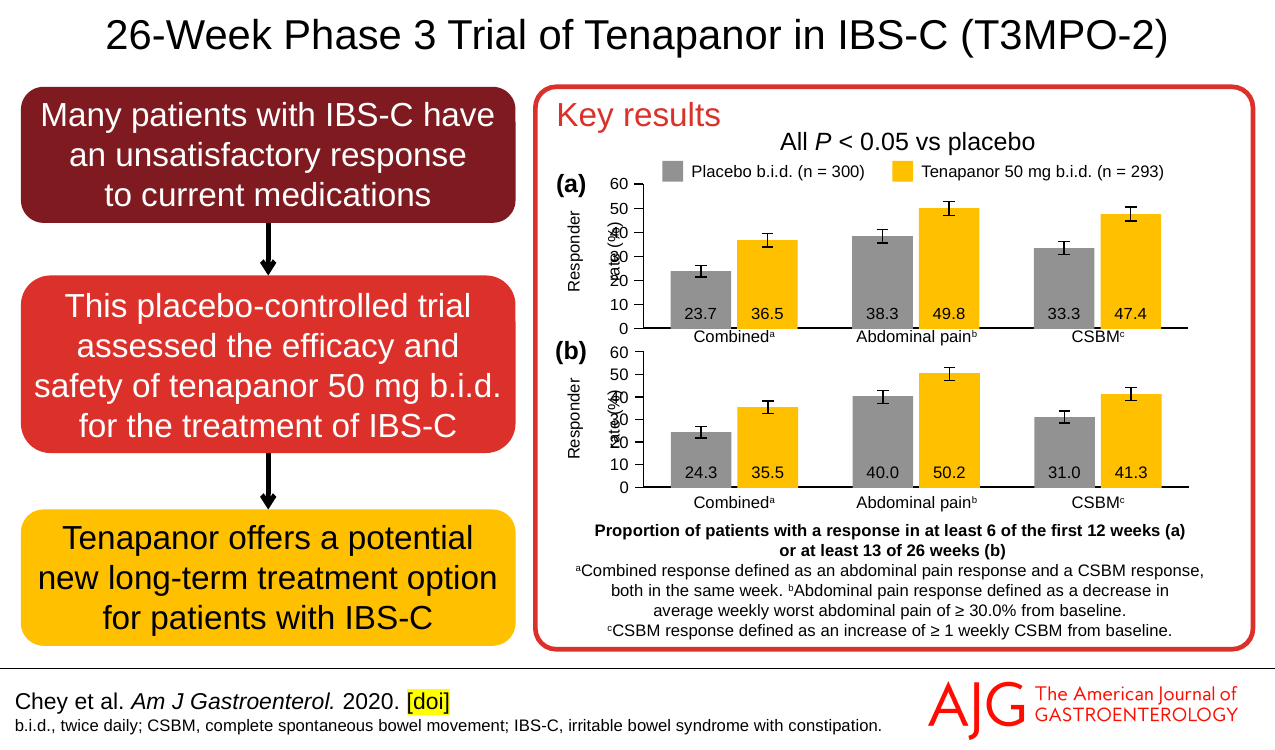
What type of chart is chart (b)? Bar chart In chart (a), what is the responder rate for Placebo b.i.d. in the Combined category? 23.7 In chart (b), what is the responder rate for Placebo b.i.d. in the CSBM category? 31.0 In chart (b), which is larger: the Tenapanor responder rate for CSBM or the Placebo responder rate for Abdominal pain? Tenapanor responder rate for CSBM In chart (b), which category has the highest Tenapanor 50 mg b.i.d. responder rate? Abdominal pain In chart (a), which category has the lowest Placebo b.i.d. responder rate? Combined What colour represents Tenapanor 50 mg b.i.d. in the charts? Yellow In chart (a), what is the responder rate for Tenapanor 50 mg b.i.d. in the Abdominal pain category? 49.8 How many categories are shown on the x axis of chart (a)? 3 How many series does the legend list for the charts? 2 In chart (b), what is the difference between the Tenapanor and Placebo responder rates in the Abdominal pain category? 10.2 In chart (a), what is the difference between the Tenapanor and Placebo responder rates in the Combined category? 12.8